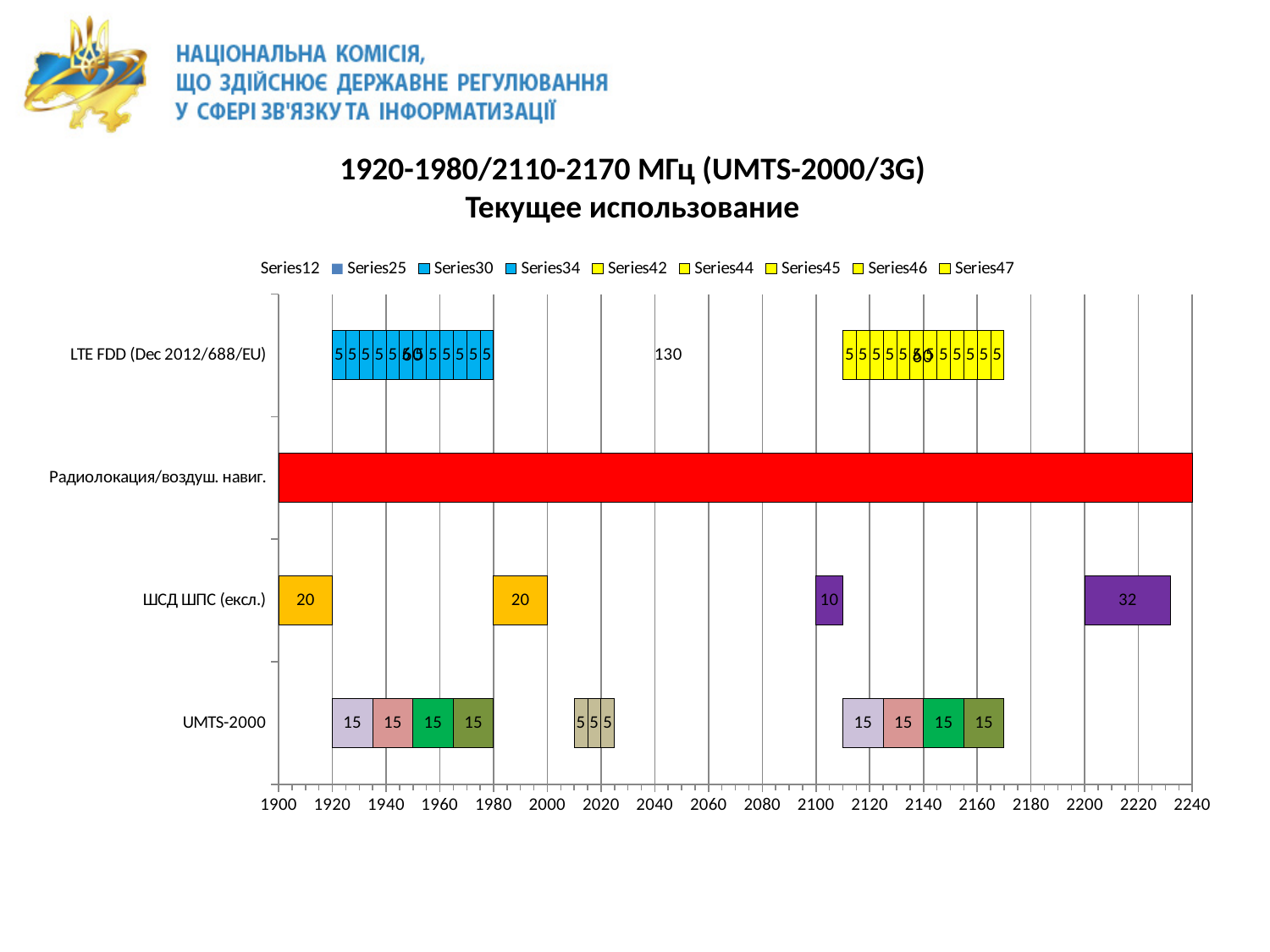
What value is printed on the widest purple segment in the ШСД ШПС (ексл.) row? 32 What value is printed on the narrow purple segment near 2100 in the ШСД ШПС (ексл.) row? 10 What value is printed on the green segment in the UMTS-2000 row? 15 What kind of chart is shown on the slide? bar chart What value is printed in the LTE FDD (Dec 2012/688/EU) row between the 2040 and 2060 ticks? 130 How many categories are listed on the vertical axis of the chart? 4 What is the total of the four labelled segments in the ШСД ШПС (ексл.) row? 82 What value is printed on each of the small tan segments near 2020 in the UMTS-2000 row? 5 What colour is the bar for Радиолокация/воздуш. навиг.? red How many series does the chart legend list? 9 What is the difference between the two purple segments in the ШСД ШПС (ексл.) row, labelled 32 and 10? 22 What value is printed on the orange segment at the far left of the ШСД ШПС (ексл.) row? 20